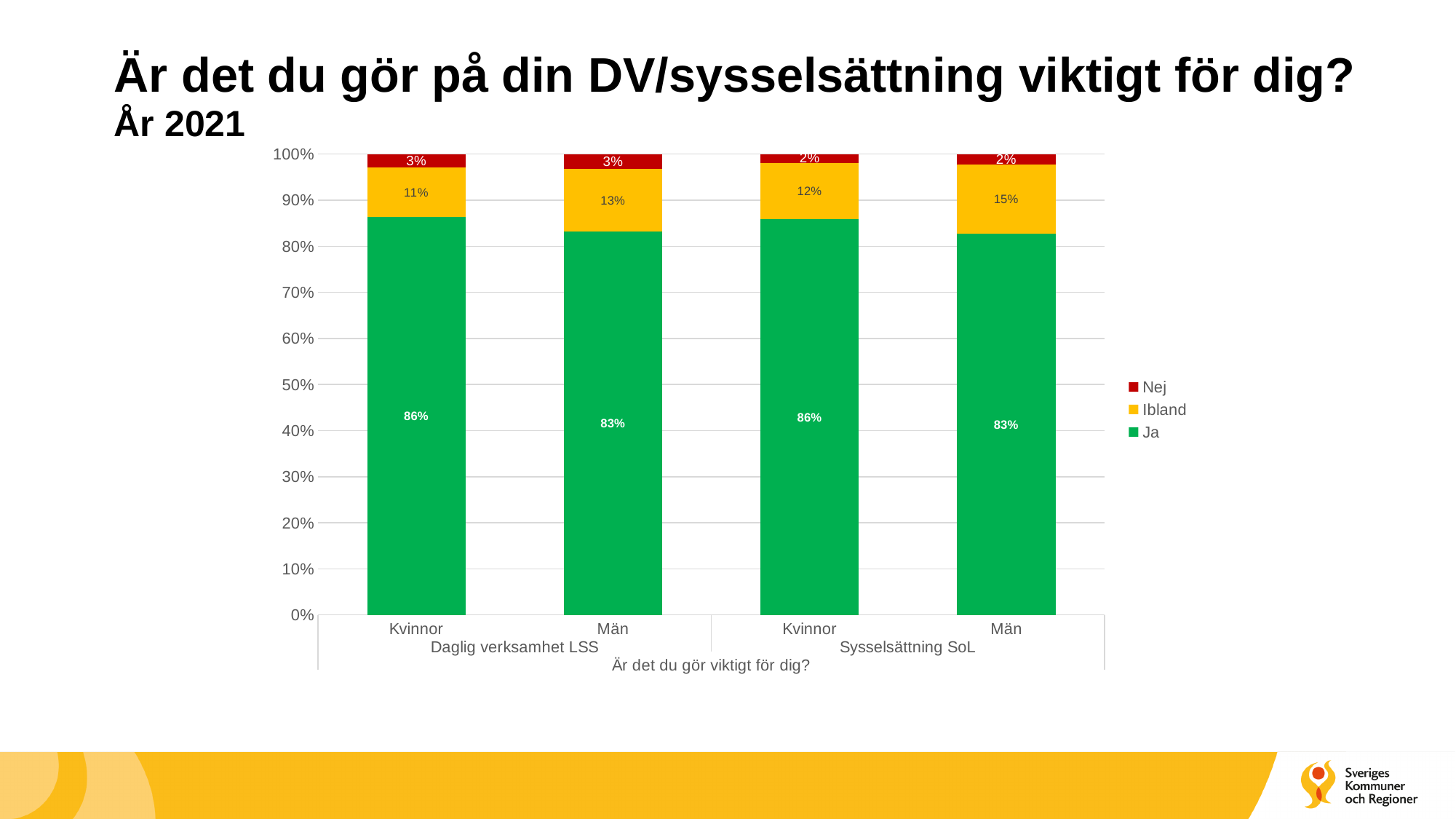
What is the 'Ja' value for Kvinnor in Daglig verksamhet LSS? 86% What kind of chart is shown on the slide? Stacked bar chart How many bars are plotted in the chart? 4 Which group has the lowest 'Ibland' value? Kvinnor, Daglig verksamhet LSS What is the difference between the 'Ibland' values for Män and Kvinnor in Daglig verksamhet LSS? 2% Which group has the highest 'Ibland' value? Män, Sysselsättning SoL What is the 'Ibland' value for Män in Sysselsättning SoL? 15% Which legend entry is shown in green? Ja What is the 'Ibland' value for Kvinnor in Sysselsättning SoL? 12% Is the 'Ja' value for Kvinnor in Daglig verksamhet LSS larger or smaller than the 'Ja' value for Män in Daglig verksamhet LSS? larger How many series does the legend list? 3 What is the 'Nej' value for Män in Daglig verksamhet LSS? 3%